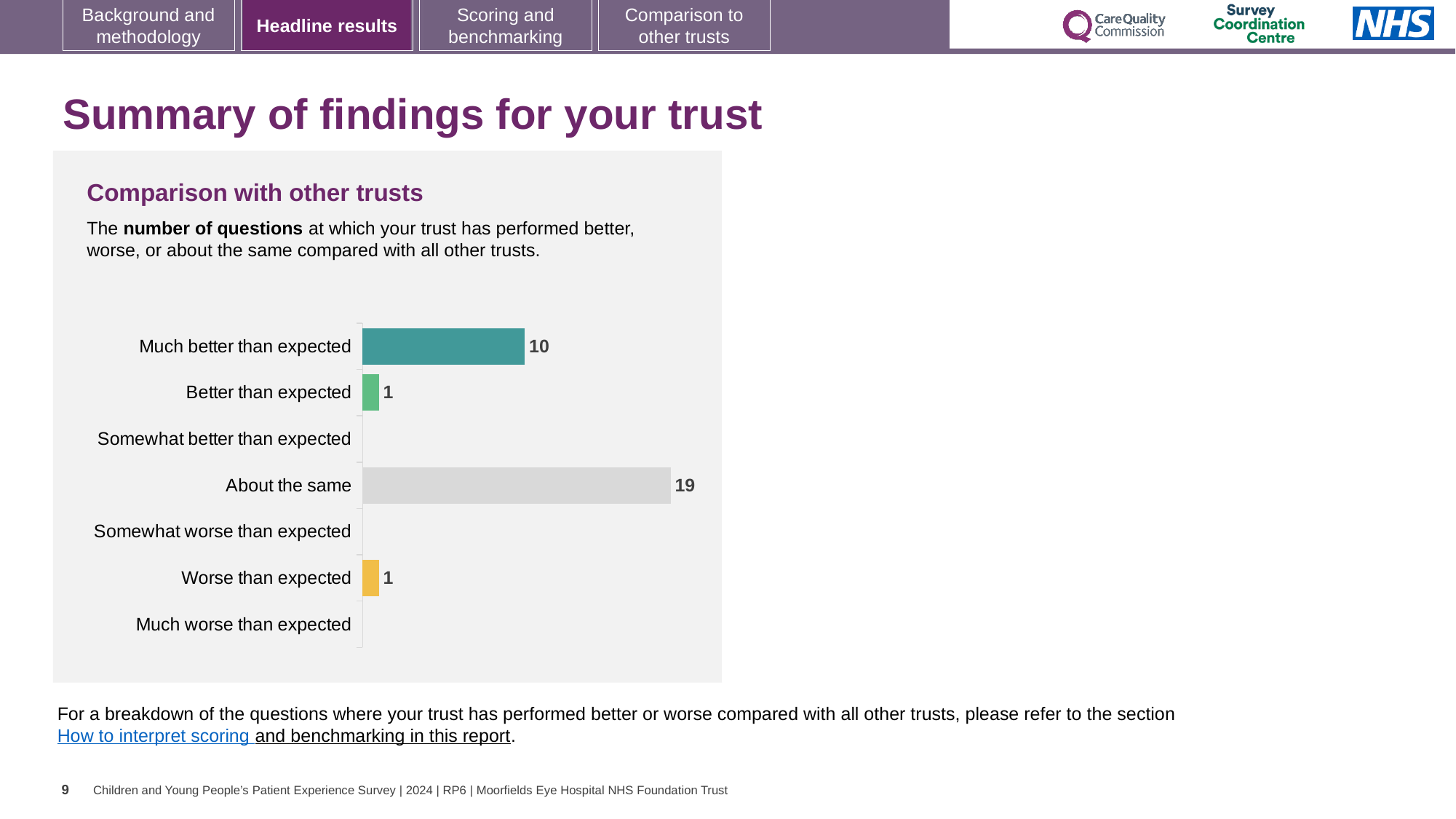
How many questions were rated 'Worse than expected'? 1 Which category has the highest number of questions? About the same How many questions were rated 'Better than expected'? 1 How many questions were rated 'About the same'? 19 How many questions were rated 'Much better than expected'? 10 What is the total number of questions across all categories shown on the chart? 31 What kind of chart is shown on the slide? Bar chart What is the title of the chart? Comparison with other trusts How many categories are shown on the chart? 7 What colour is the bar for 'About the same'? Grey Which is larger: the number of questions rated 'Much better than expected' or 'Worse than expected'? Much better than expected What is the difference between the number of questions rated 'About the same' and 'Much better than expected'? 9